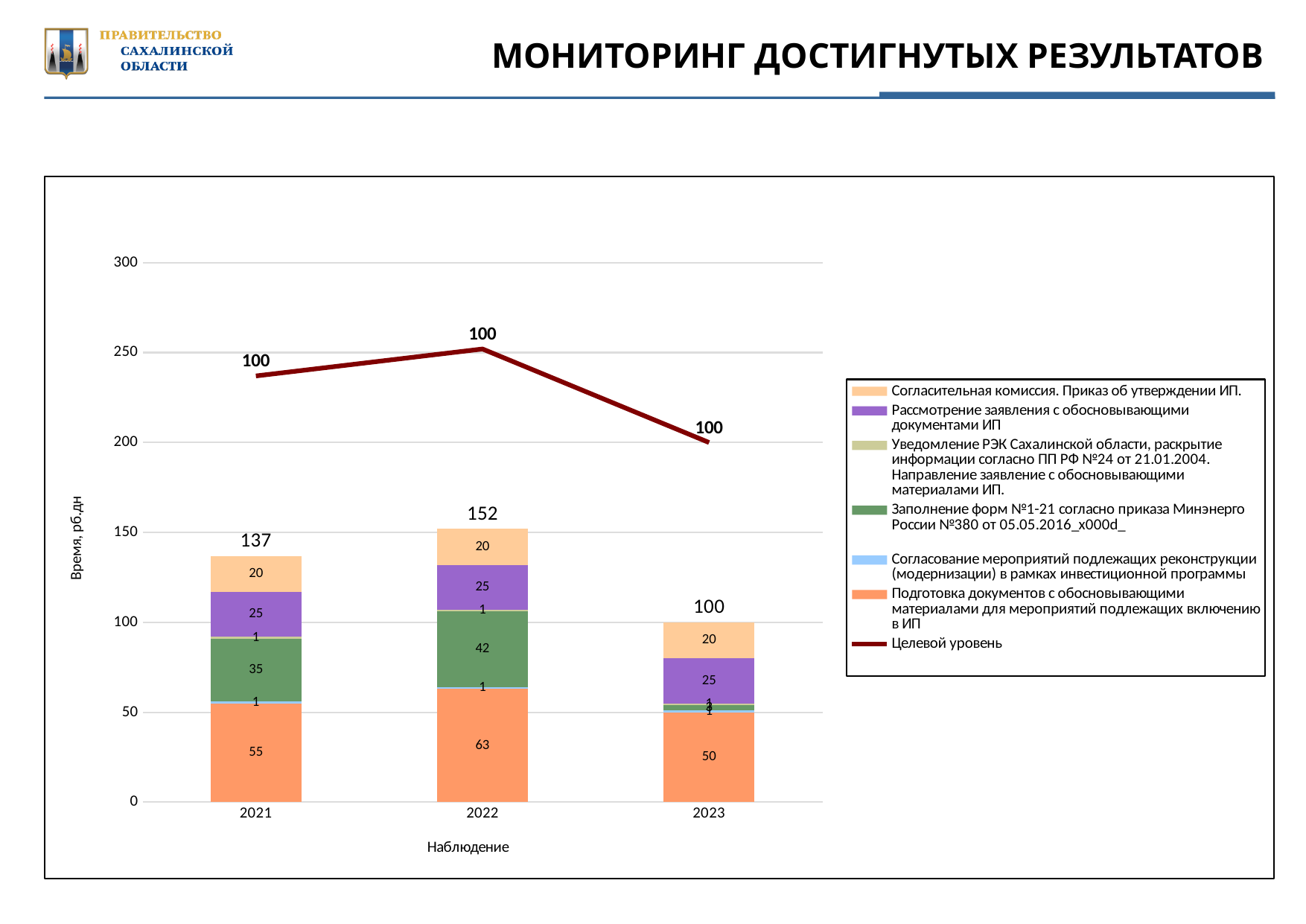
What is the value of the 'Подготовка документов с обосновывающими материалами для мероприятий подлежащих включению в ИП' segment in 2022? 63 What is the value of the 'Согласительная комиссия. Приказ об утверждении ИП.' segment in 2023? 20 How many years are shown on the x axis? 3 What is the total value of the stacked bar for 2021? 137 Is the 'Подготовка документов' segment larger in 2022 or in 2021? 2022 What is the value of the 'Заполнение форм №1-21 согласно приказа Минэнерго России №380 от 05.05.2016' segment in 2021? 35 How many entries does the legend list? 7 Which year has the highest stacked bar total? 2022 What is the total value of the stacked bar for 2022? 152 What is the difference between the stacked bar totals for 2022 and 2021? 15 What is the value of the 'Целевой уровень' line for 2023? 100 Which year has the lowest stacked bar total? 2023